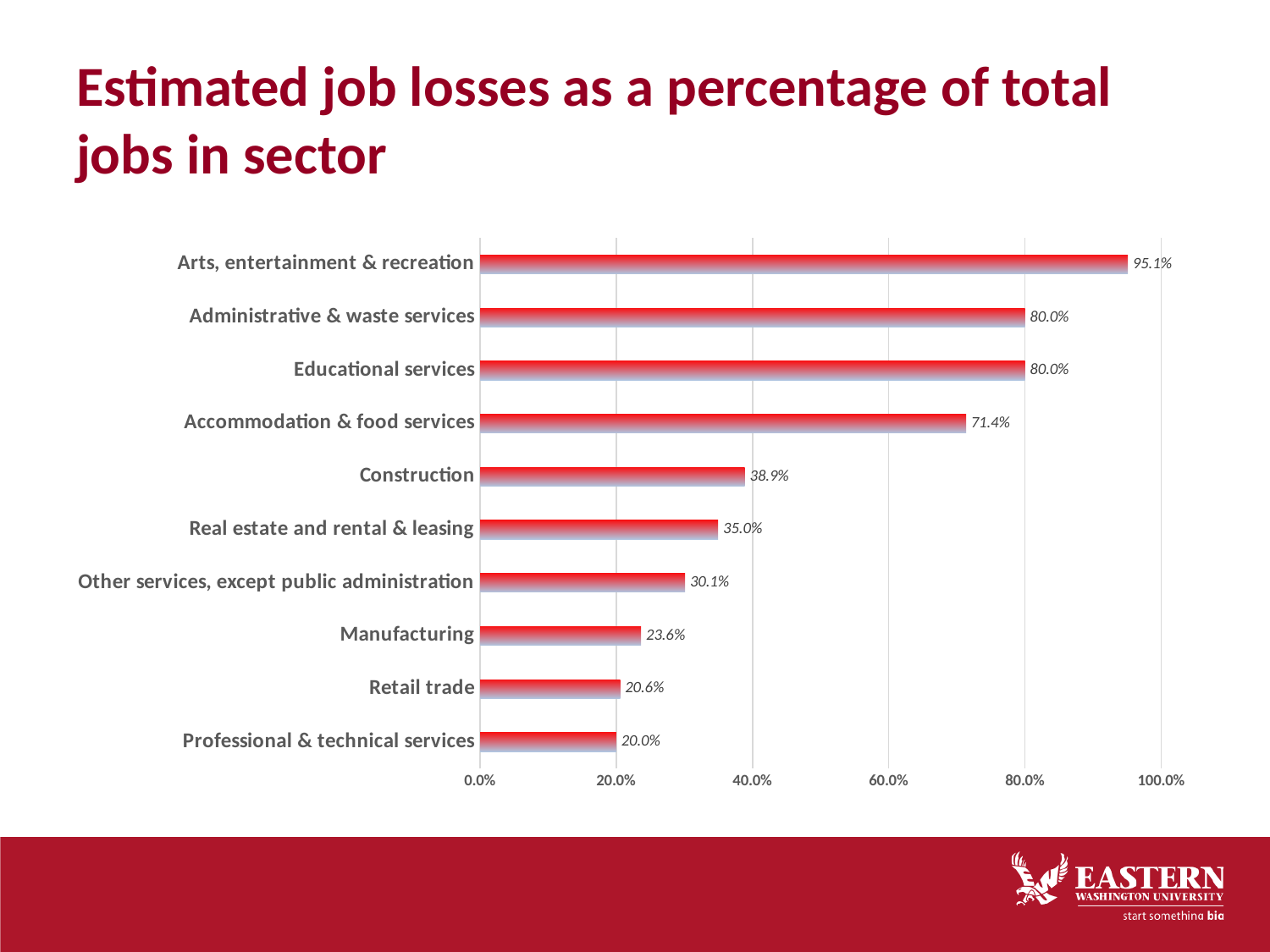
What is the title of the slide? Estimated job losses as a percentage of total jobs in sector What is the difference between the values for Arts, entertainment & recreation and Construction? 56.2% What is the estimated job loss percentage for Arts, entertainment & recreation? 95.1% Which sector has the lowest estimated job loss percentage? Professional & technical services Which is larger, the value for Construction or the value for Real estate and rental & leasing? Construction What kind of chart is shown on the slide? Bar chart What is the value shown for Manufacturing? 23.6% What is the difference between the values for Retail trade and Professional & technical services? 0.6% Is the value for Other services, except public administration greater or less than 40.0%? less What is the value shown for Accommodation & food services? 71.4% Which sector has the highest estimated job loss percentage? Arts, entertainment & recreation How many sectors are shown in the chart? 10